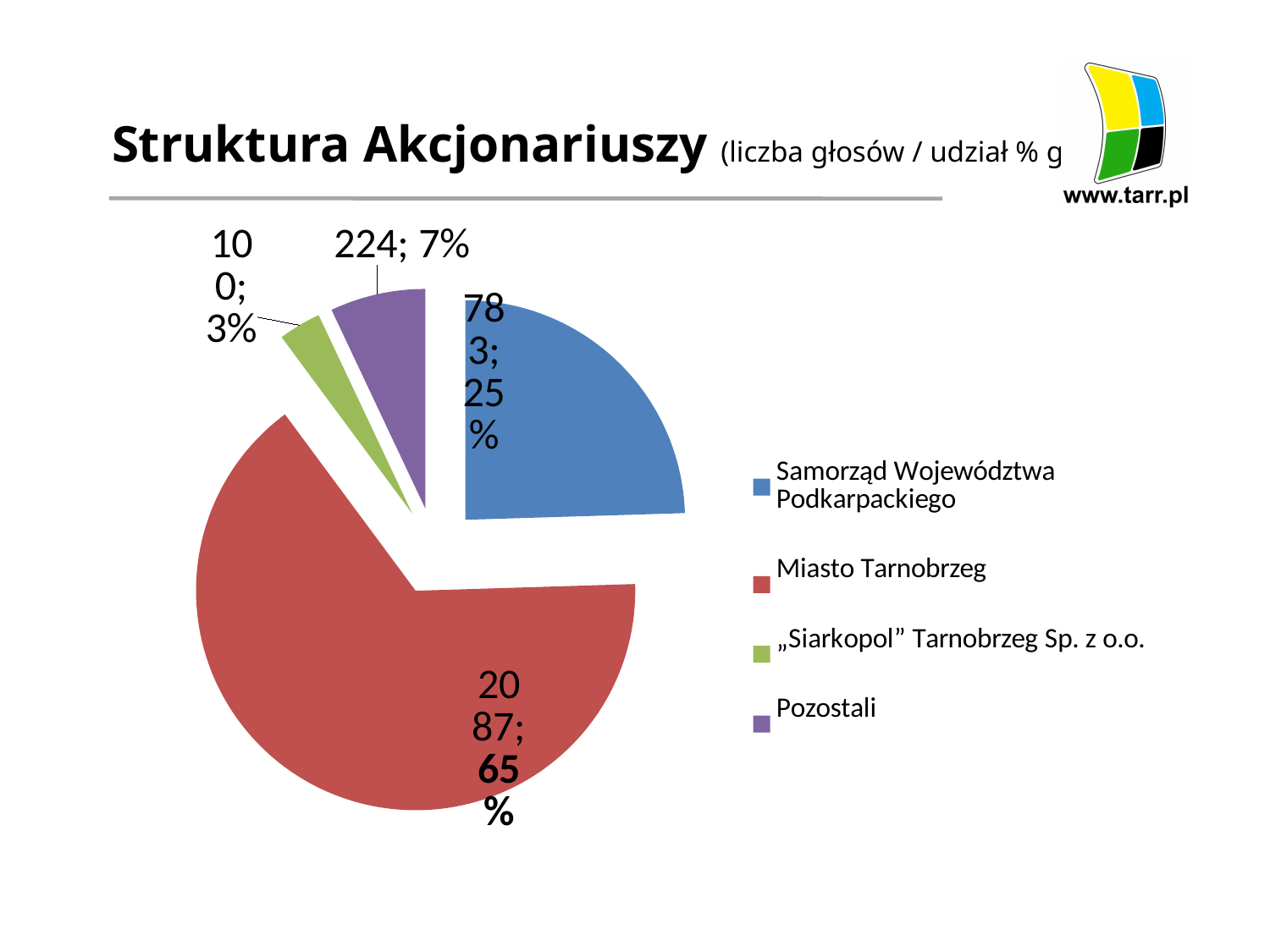
How many slices does the pie chart have? 4 What percentage share is shown for „Siarkopol” Tarnobrzeg Sp. z o.o.? 3% How many entries does the legend list? 4 What number of votes is shown for Pozostali? 224 What percentage share is shown for Samorząd Województwa Podkarpackiego? 25% Which shareholder has the largest slice of the pie? Miasto Tarnobrzeg What percentage share is shown for Miasto Tarnobrzeg? 65% Which shareholder has the smallest slice of the pie? „Siarkopol” Tarnobrzeg Sp. z o.o. What is the difference in votes between Pozostali and „Siarkopol” Tarnobrzeg Sp. z o.o.? 124 What number of votes is shown for Miasto Tarnobrzeg? 2087 What number of votes is shown for Samorząd Województwa Podkarpackiego? 783 What kind of chart is shown on the slide? pie chart